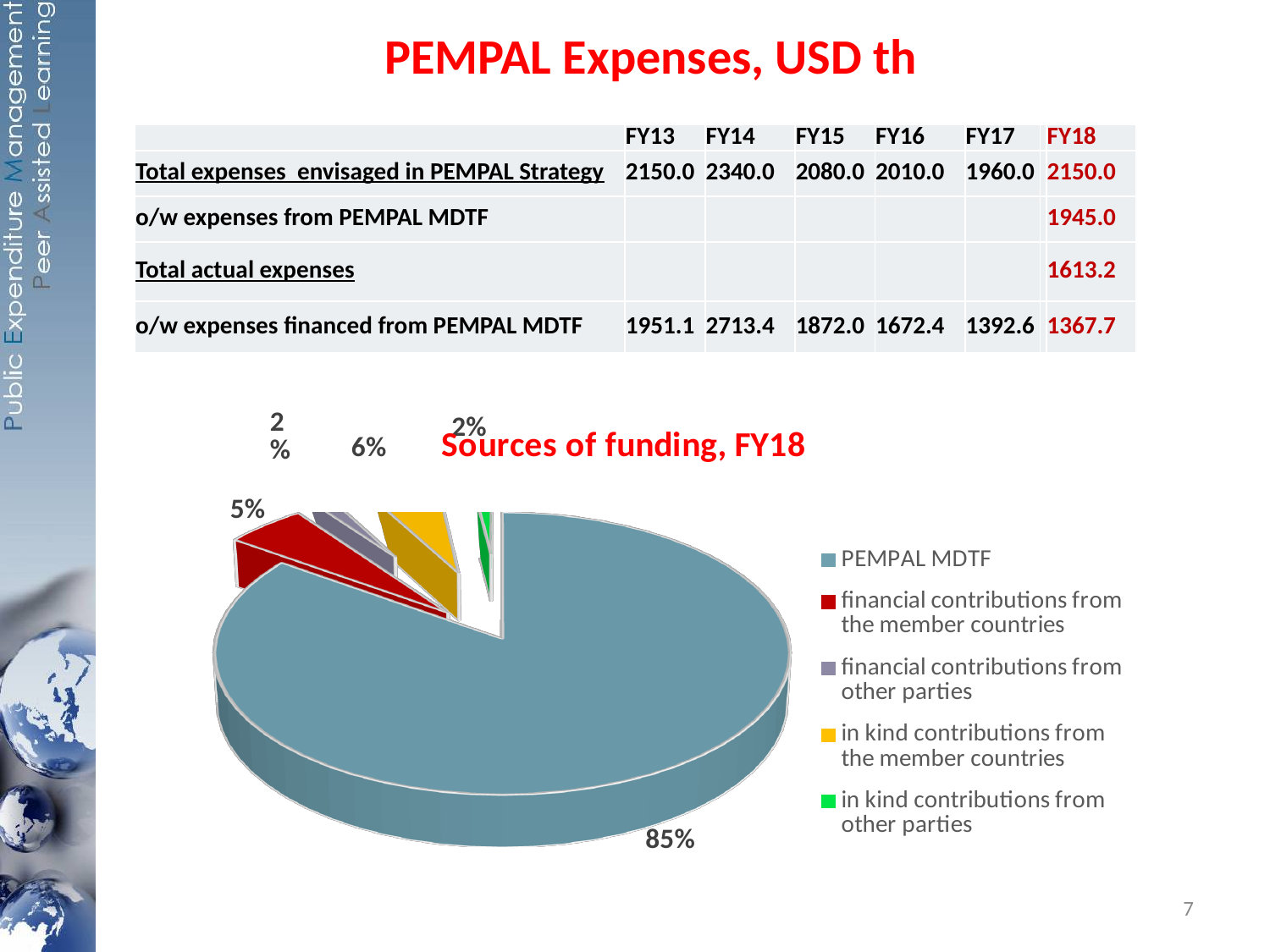
What is the title of the pie chart on the slide? Sources of funding, FY18 In the "Sources of funding, FY18" pie chart, which is larger: in kind contributions from the member countries or financial contributions from the member countries? in kind contributions from the member countries How many sources of funding does the legend of the "Sources of funding, FY18" pie chart list? 5 In the "Sources of funding, FY18" pie chart, what is the difference in percentage points between the PEMPAL MDTF share and the in kind contributions from the member countries share? 79 In the "Sources of funding, FY18" pie chart, what share comes from in kind contributions from the member countries? 6% In the "Sources of funding, FY18" pie chart, what share comes from in kind contributions from other parties? 2% What kind of chart is shown under the title "Sources of funding, FY18"? pie chart In the "Sources of funding, FY18" pie chart, what share does PEMPAL MDTF account for? 85% Which source is the largest slice in the "Sources of funding, FY18" pie chart? PEMPAL MDTF In the "Sources of funding, FY18" pie chart, is the PEMPAL MDTF share greater or less than 50%? greater In the "Sources of funding, FY18" pie chart, what colour is the PEMPAL MDTF slice? teal blue